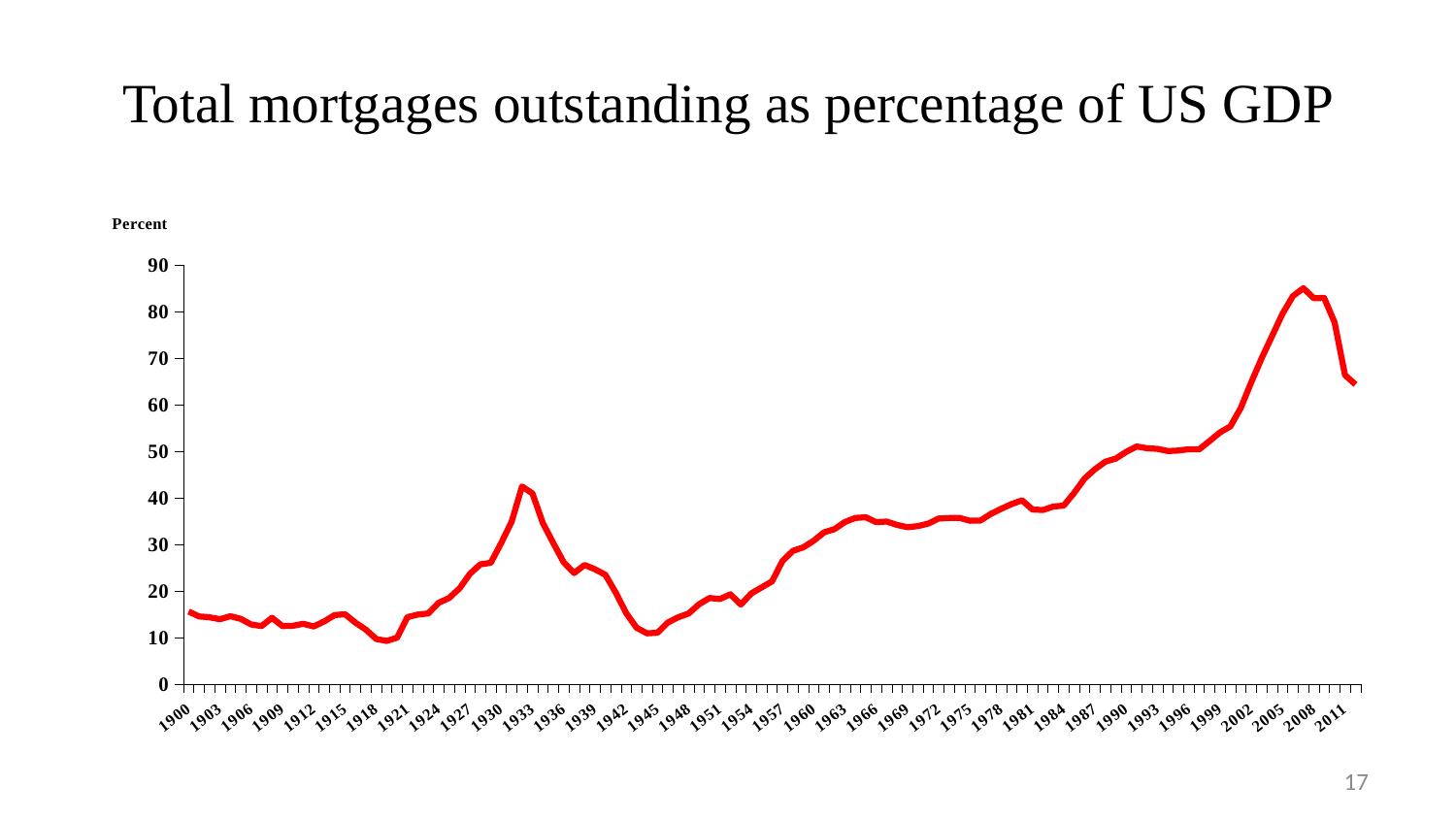
Is the value for 2005 greater or less than 70? greater What label is shown on the vertical axis of the chart? Percent Which year has the higher value, 1933 or 2008? 2008 Is the value for 1900 greater or less than 20? less What is the title of the chart? Total mortgages outstanding as percentage of US GDP Does the line generally rise or fall between 1945 and 2008? rise Which year has the higher value, 1945 or 1975? 1975 Is the value for 1984 greater or less than 40? less What kind of chart is shown on the slide? line chart